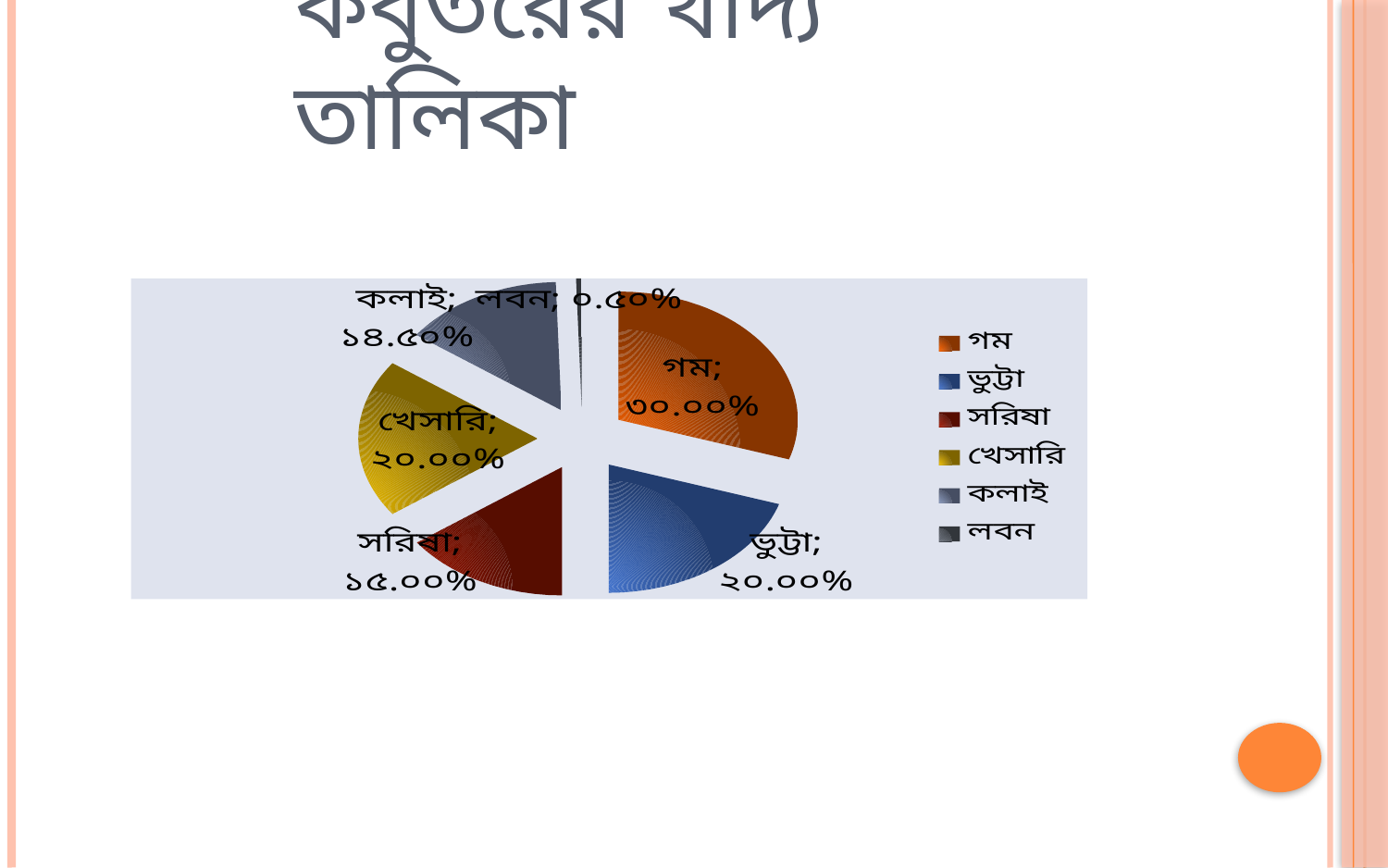
What percentage does the গম slice represent? ৩০.০০% What percentage does the লবন slice represent? ০.৫০% Which is larger, the share for সরিষা or the share for খেসারি? খেসারি Which category has the largest share of the pie? গম What percentage does the কলাই slice represent? ১৪.৫০% What colour is used for the গম slice in the legend? orange What kind of chart is shown on the slide? pie chart What is the difference between the গম share and the সরিষা share? ১৫.০০% Which category has the smallest share of the pie? লবন What percentage does the সরিষা slice represent? ১৫.০০% What percentage does the ভুট্টা slice represent? ২০.০০% How many categories does the pie chart have? 6